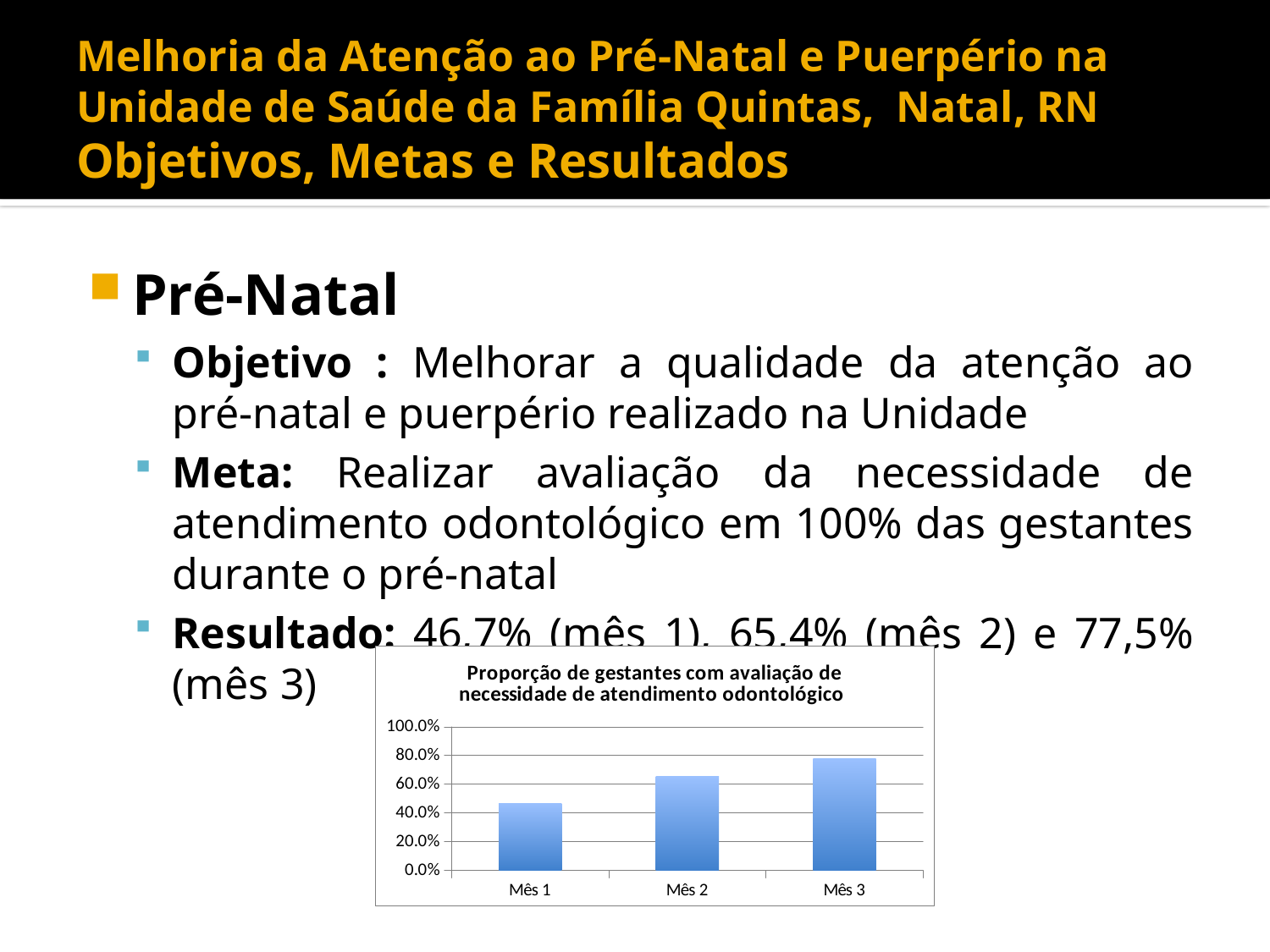
Is the value for Mês 1 greater or less than 60.0%? less Which is larger, the value for Mês 1 or the value for Mês 2? Mês 2 Which month has the lowest bar in the chart? Mês 1 What is the title of the chart? Proporção de gestantes com avaliação de necessidade de atendimento odontológico Is the value for Mês 3 greater or less than 60.0%? greater What is the highest value shown on the y axis of the chart? 100.0% Do the values rise or fall from Mês 1 to Mês 3? rise What kind of chart is shown on the slide? bar chart Is the value for Mês 3 greater or less than 80.0%? less How many categories (months) are shown on the x axis of the chart? 3 Which month has the highest bar in the chart? Mês 3